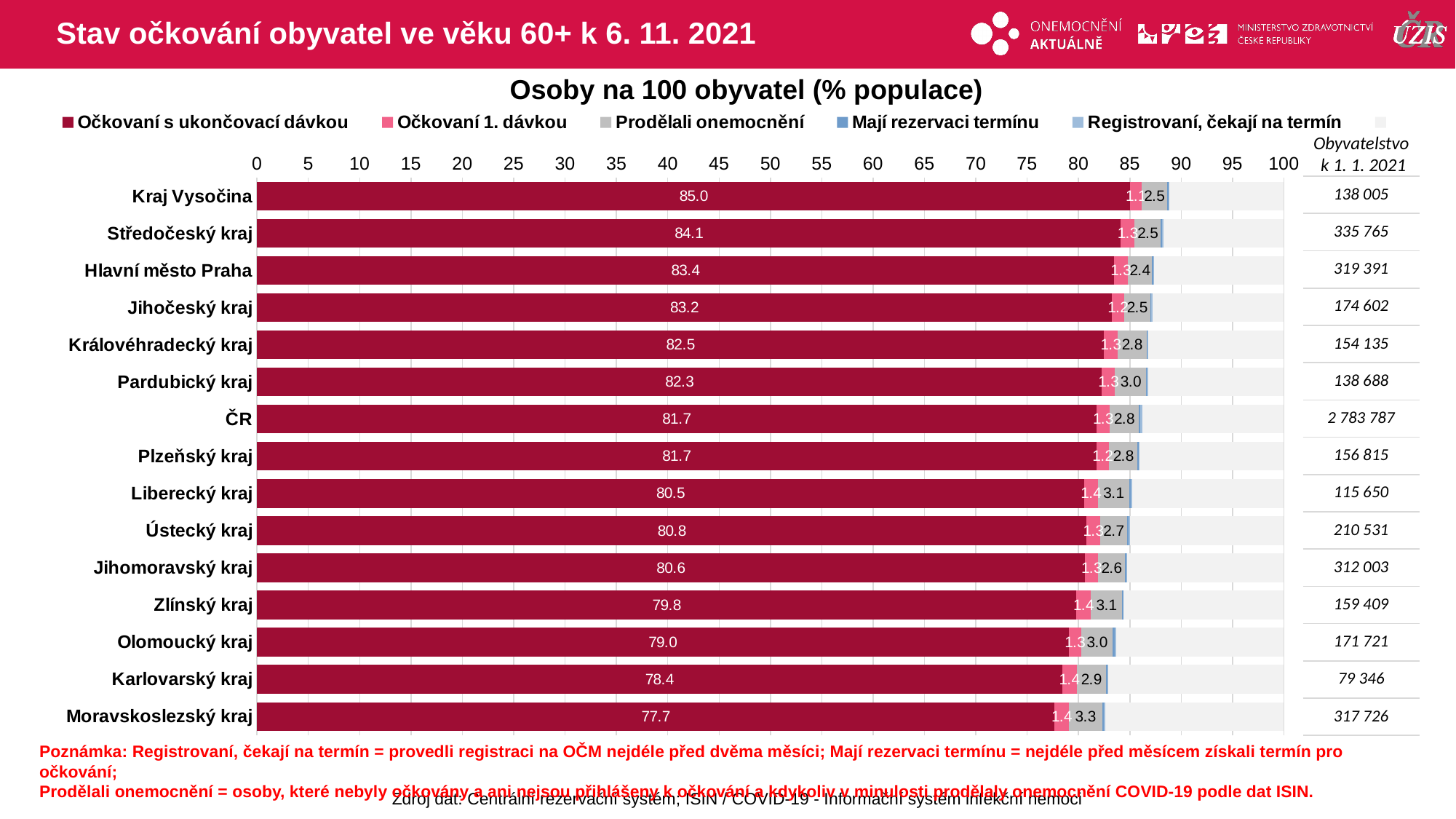
Is the 'Očkovaní s ukončovací dávkou' value for Olomoucký kraj greater or less than 80? less What is the value of 'Očkovaní s ukončovací dávkou' for ČR? 81.7 What is the difference in 'Očkovaní s ukončovací dávkou' between Kraj Vysočina and Moravskoslezský kraj? 7.3 Which region has the highest value for 'Očkovaní s ukončovací dávkou'? Kraj Vysočina Which has a larger 'Prodělali onemocnění' value, Pardubický kraj or Kraj Vysočina? Pardubický kraj How many regions (categories) are plotted in the chart? 15 Which has a larger 'Očkovaní s ukončovací dávkou' value, Středočeský kraj or Hlavní město Praha? Středočeský kraj What is the value of 'Očkovaní s ukončovací dávkou' for Kraj Vysočina? 85.0 Which region has the lowest value for 'Očkovaní s ukončovací dávkou'? Moravskoslezský kraj What type of chart is shown on the slide? bar chart What is the title of the chart? Osoby na 100 obyvatel (% populace) What is the value of 'Prodělali onemocnění' for Moravskoslezský kraj? 3.3